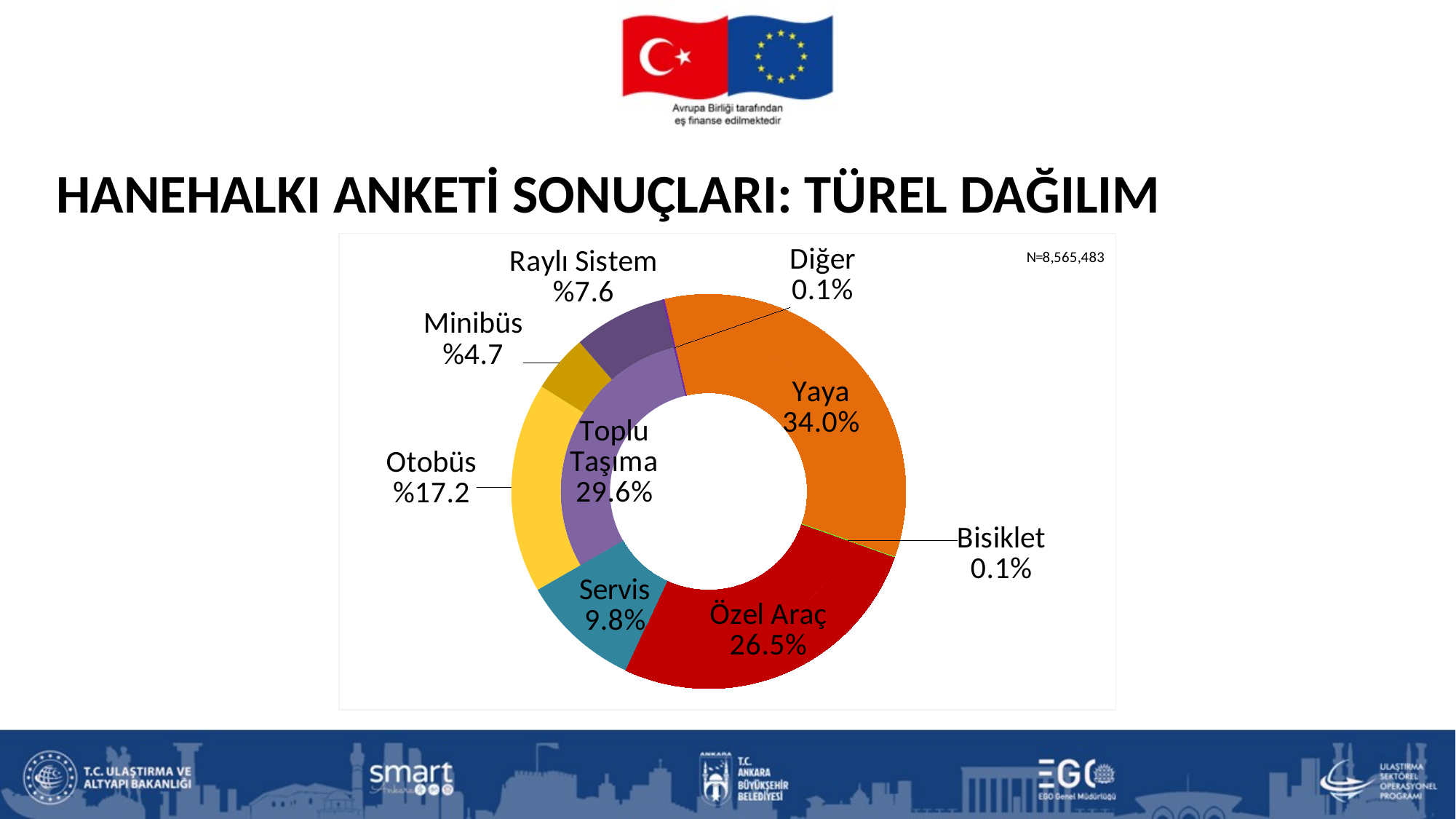
Which of the three Toplu Taşıma sub-categories (Otobüs, Raylı Sistem, Minibüs) has the smallest share? Minibüs What share does Yaya have in the chart? 34.0% What is the value shown for Minibüs? %4.7 What is the value shown for Raylı Sistem? %7.6 What kind of chart is shown on the slide? doughnut chart Which category has the largest share in the chart? Yaya What share does Servis have? 9.8% What is the difference in percentage points between Yaya and Özel Araç? 7.5 What is the difference in percentage points between Otobüs and Raylı Sistem? 9.6 What sample size (N) is printed on the chart? N=8,565,483 What is the value shown for Otobüs? %17.2 Which is larger, Toplu Taşıma or Özel Araç? Toplu Taşıma